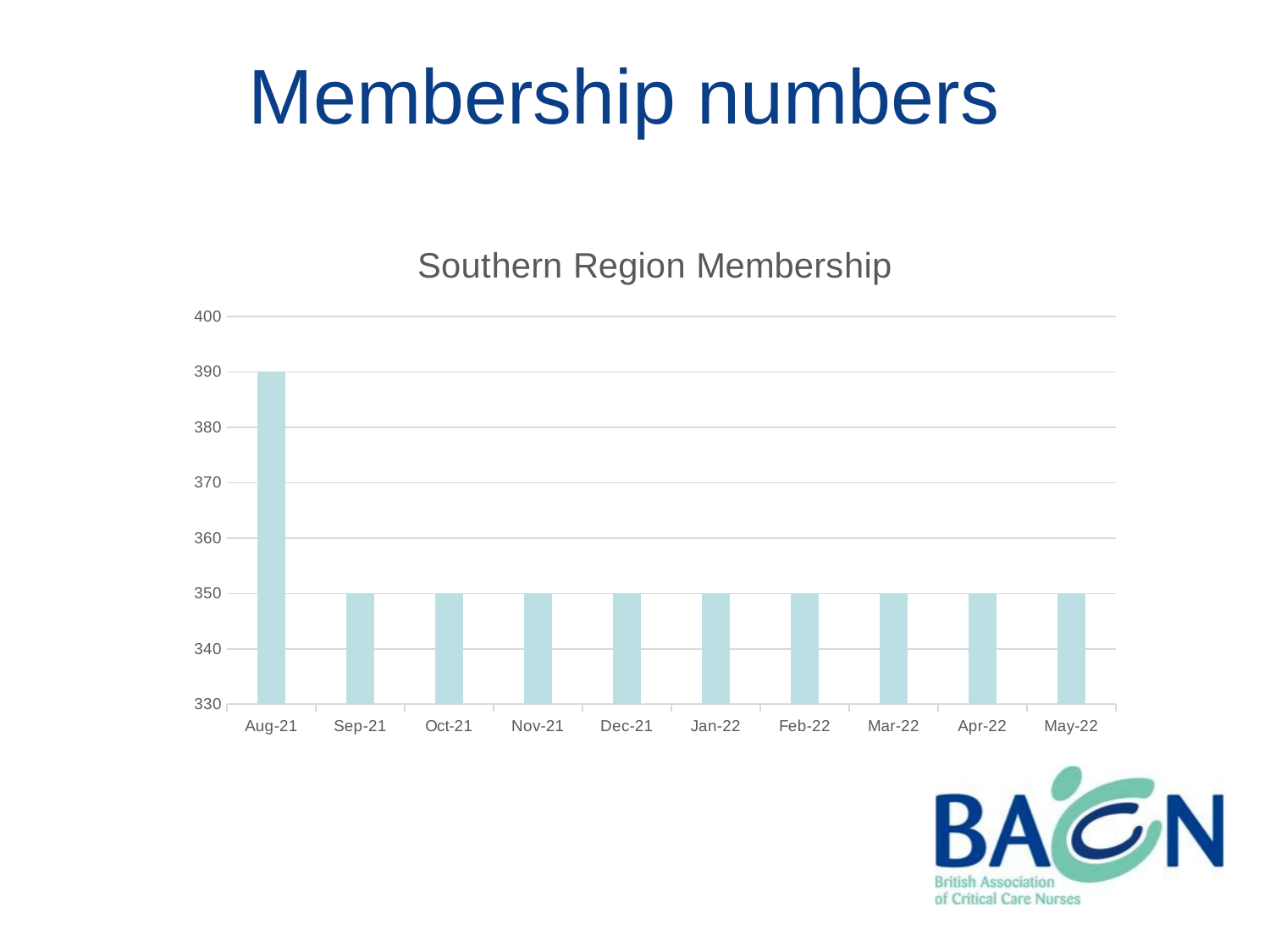
How many months are shown on the x axis of the chart? 10 What is the membership value for May-22? 350 What is the difference between the membership in Aug-21 and Sep-21? 40 What kind of chart is shown on the slide? bar chart Is the value for Dec-21 greater or less than 360? less Which month has the highest membership? Aug-21 What is the membership value for Aug-21? 390 Is the value for Aug-21 greater or less than 380? greater Which is larger, the membership in Aug-21 or in Jan-22? Aug-21 What is the membership value for Sep-21? 350 What is the title of the chart? Southern Region Membership Do the membership values rise or fall from Aug-21 to Sep-21? fall